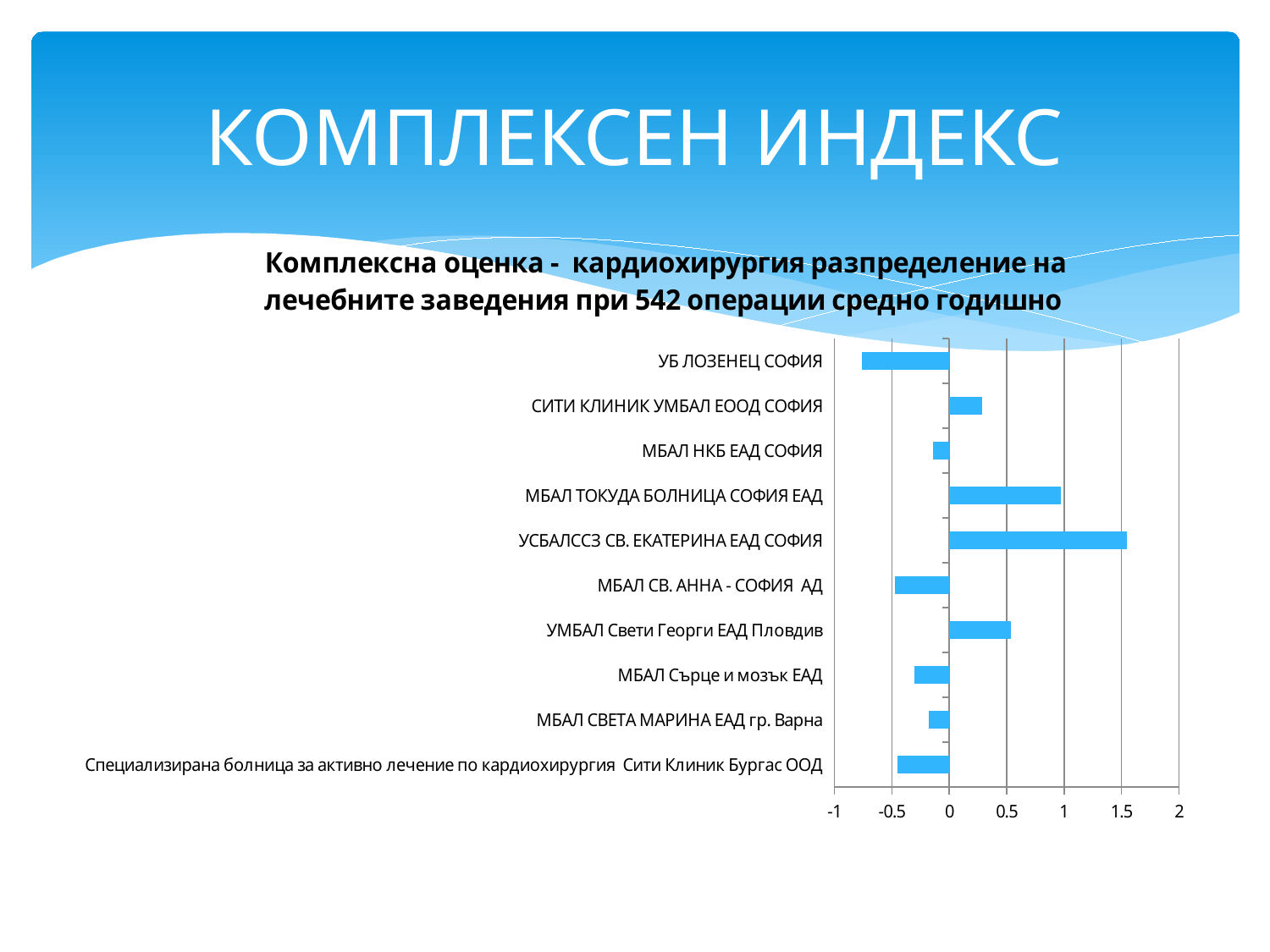
What is the title of the chart? Комплексна оценка - кардиохирургия разпределение на лечебните заведения при 542 операции средно годишно Is the value for УБ ЛОЗЕНЕЦ СОФИЯ greater or less than -0.5? less What kind of chart is shown on the slide? bar chart How many hospitals (categories) are plotted in the chart? 10 Which hospital has the lowest value in the chart? УБ ЛОЗЕНЕЦ СОФИЯ Which has the larger value: МБАЛ СВ. АННА - СОФИЯ АД or УБ ЛОЗЕНЕЦ СОФИЯ? МБАЛ СВ. АННА - СОФИЯ АД Is the value for СИТИ КЛИНИК УМБАЛ ЕООД СОФИЯ greater or less than 0.5? less Is the value for МБАЛ ТОКУДА БОЛНИЦА СОФИЯ ЕАД greater or less than 0.5? greater Which hospital has the highest value in the chart? УСБАЛССЗ СВ. ЕКАТЕРИНА ЕАД СОФИЯ Which has the larger value: МБАЛ ТОКУДА БОЛНИЦА СОФИЯ ЕАД or УМБАЛ Свети Георги ЕАД Пловдив? МБАЛ ТОКУДА БОЛНИЦА СОФИЯ ЕАД